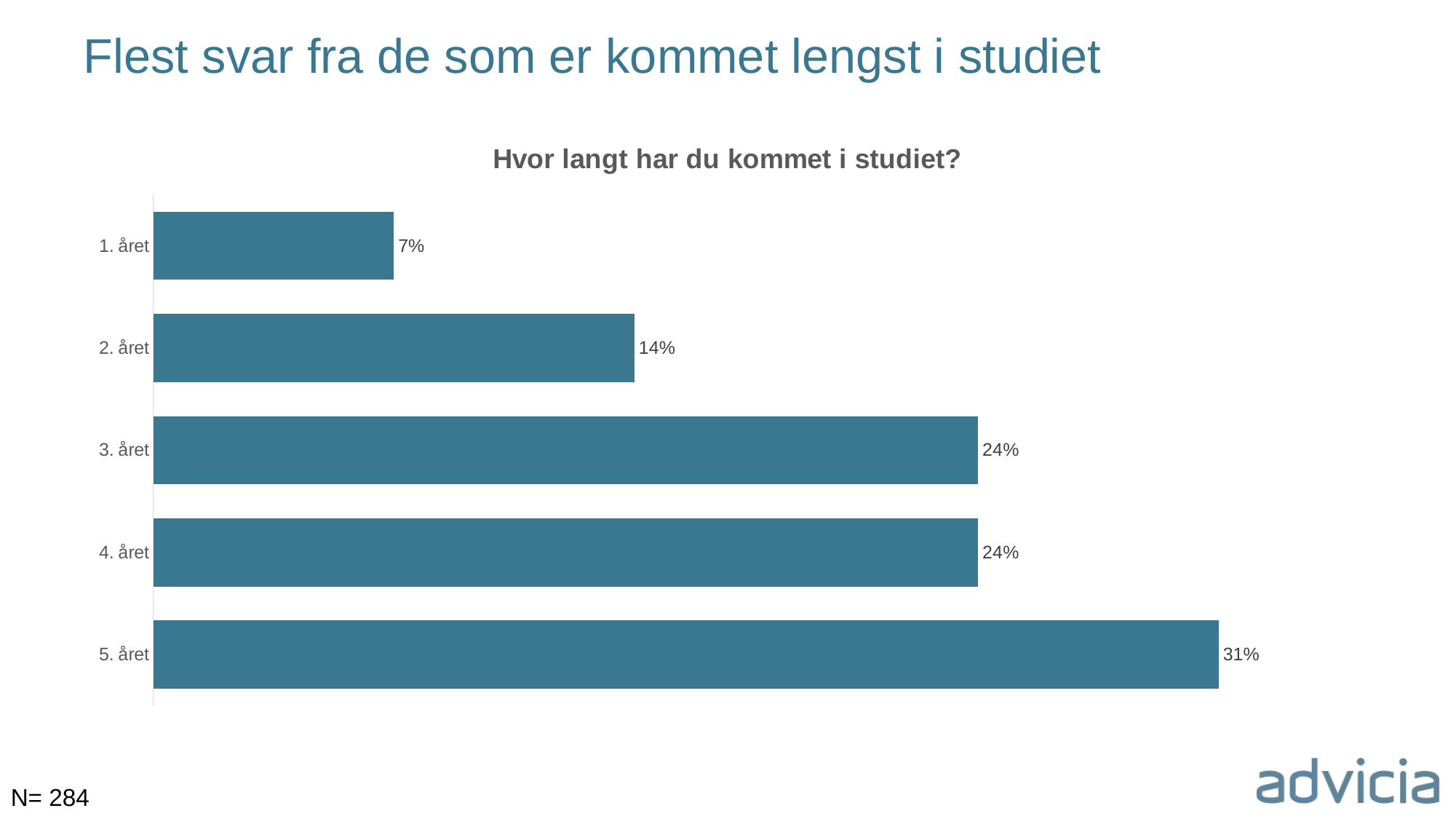
Which category has the highest value? 5. året Which two categories have the same value? 3. året and 4. året What is the value for 1. året? 7% How many categories are shown in the chart? 5 What is the difference between the values for 2. året and 1. året? 7% What is the difference between the values for 5. året and 1. året? 24% Which is larger, the value for 2. året or the value for 3. året? 3. året Which category has the lowest value? 1. året What kind of chart is shown on the slide? Bar chart What is the value for 5. året? 31% What is the value for 2. året? 14% What is the title of the chart? Hvor langt har du kommet i studiet?